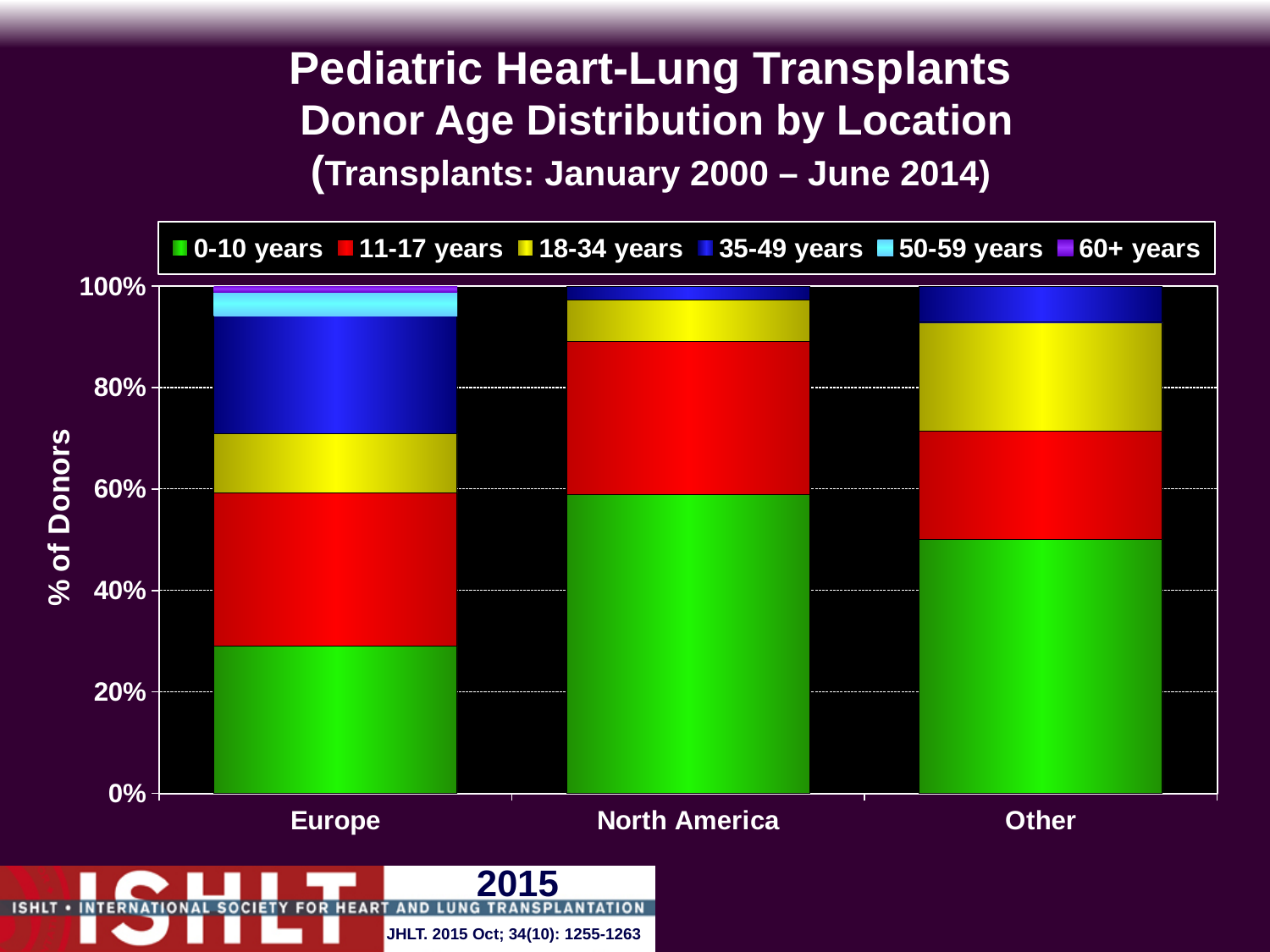
Which location has the largest share of donors aged 0-10 years? North America Which location has a larger share of donors aged 35-49 years, Europe or North America? Europe Which location has a larger share of donors aged 18-34 years, Europe or Other? Other What kind of chart is shown on the slide? Stacked bar chart How many donor age groups does the legend list? 6 Is the share of donors aged 0-10 years in Other greater or less than 60%? less Is the share of donors aged 0-10 years in Europe greater or less than 40%? less How many locations are shown on the x axis of the chart? 3 Is the share of donors aged 0-10 years in North America greater or less than 40%? greater Which donor age group is shown in green in the legend? 0-10 years What is the label of the y axis? % of Donors Which location has the smallest share of donors aged 0-10 years? Europe